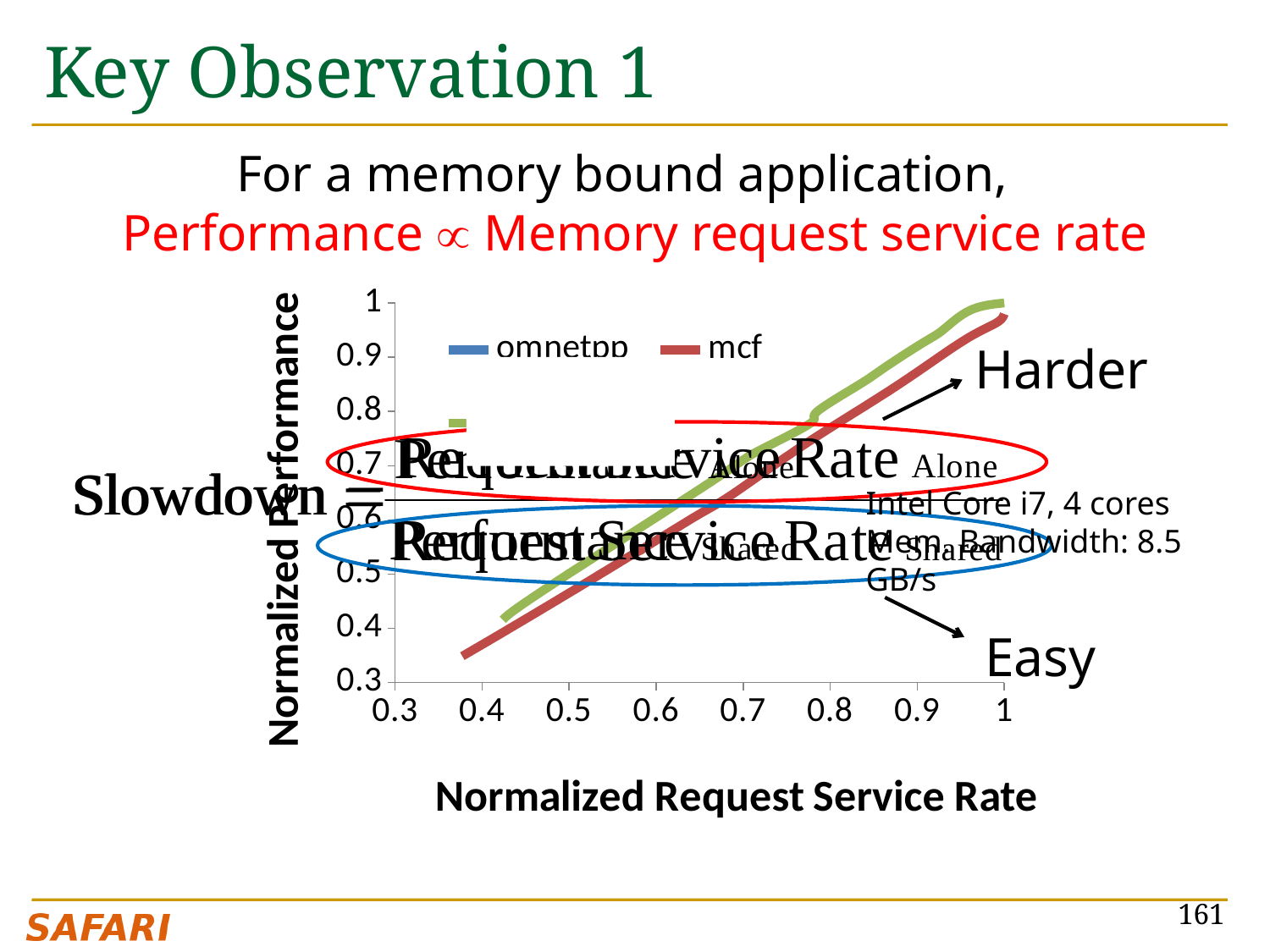
Is the Normalized Performance of mcf at a Normalized Request Service Rate of 1 greater or less than 0.9? greater Which two series are listed in the chart legend? omnetpp and mcf Do the plotted values rise or fall as Normalized Request Service Rate increases? rise Is the Normalized Performance of mcf at a Normalized Request Service Rate of 0.4 greater or less than 0.5? less What is the title of the chart's x axis? Normalized Request Service Rate What kind of chart is shown on the slide? line chart How many series does the chart legend list? 2